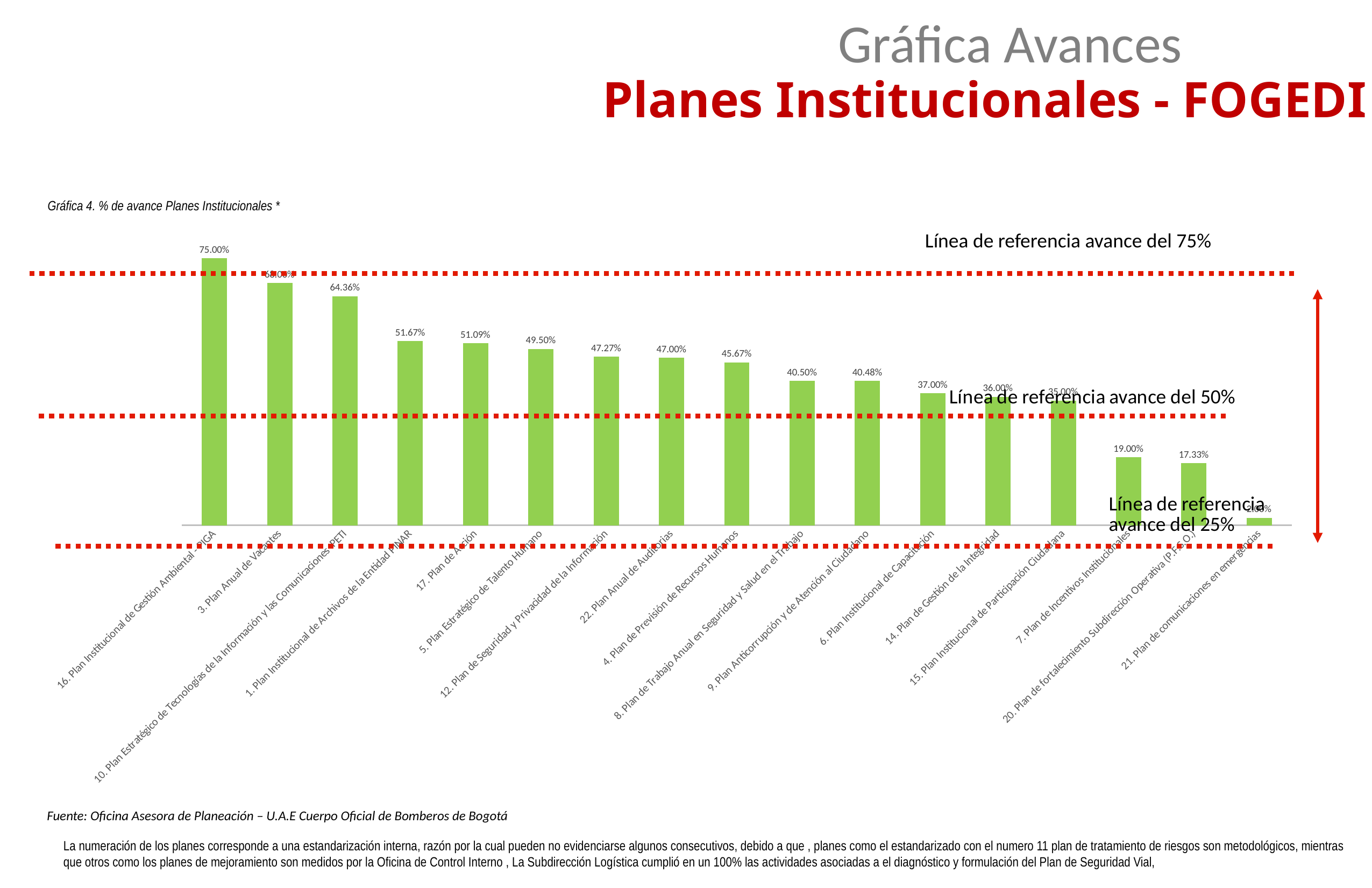
Do the values rise or fall from left to right along the x axis? Fall What kind of chart is shown on the slide? Bar chart Which plan has the highest percentage of progress? 16. Plan Institucional de Gestión Ambiental - PIGA Which plan has the lowest percentage of progress? 21. Plan de comunicaciones en emergencias What is the value for 7. Plan de Incentivos Institucionales? 19.00% What is the value for 17. Plan de Acción? 51.09% What is the difference between the values for 16. Plan Institucional de Gestión Ambiental - PIGA and 10. Plan Estratégico de Tecnologías de la Información y las Comunicaciones - PETI? 10.64% How many plans (bars) are shown in the chart? 17 What is the value for 16. Plan Institucional de Gestión Ambiental - PIGA? 75.00% What is the value for 10. Plan Estratégico de Tecnologías de la Información y las Comunicaciones - PETI? 64.36% What is the difference between the values for 7. Plan de Incentivos Institucionales and 20. Plan de fortalecimiento Subdirección Operativa (P.F.S.O.)? 1.67% Which is larger, the value for 17. Plan de Acción or the value for 5. Plan Estratégico de Talento Humano? 17. Plan de Acción